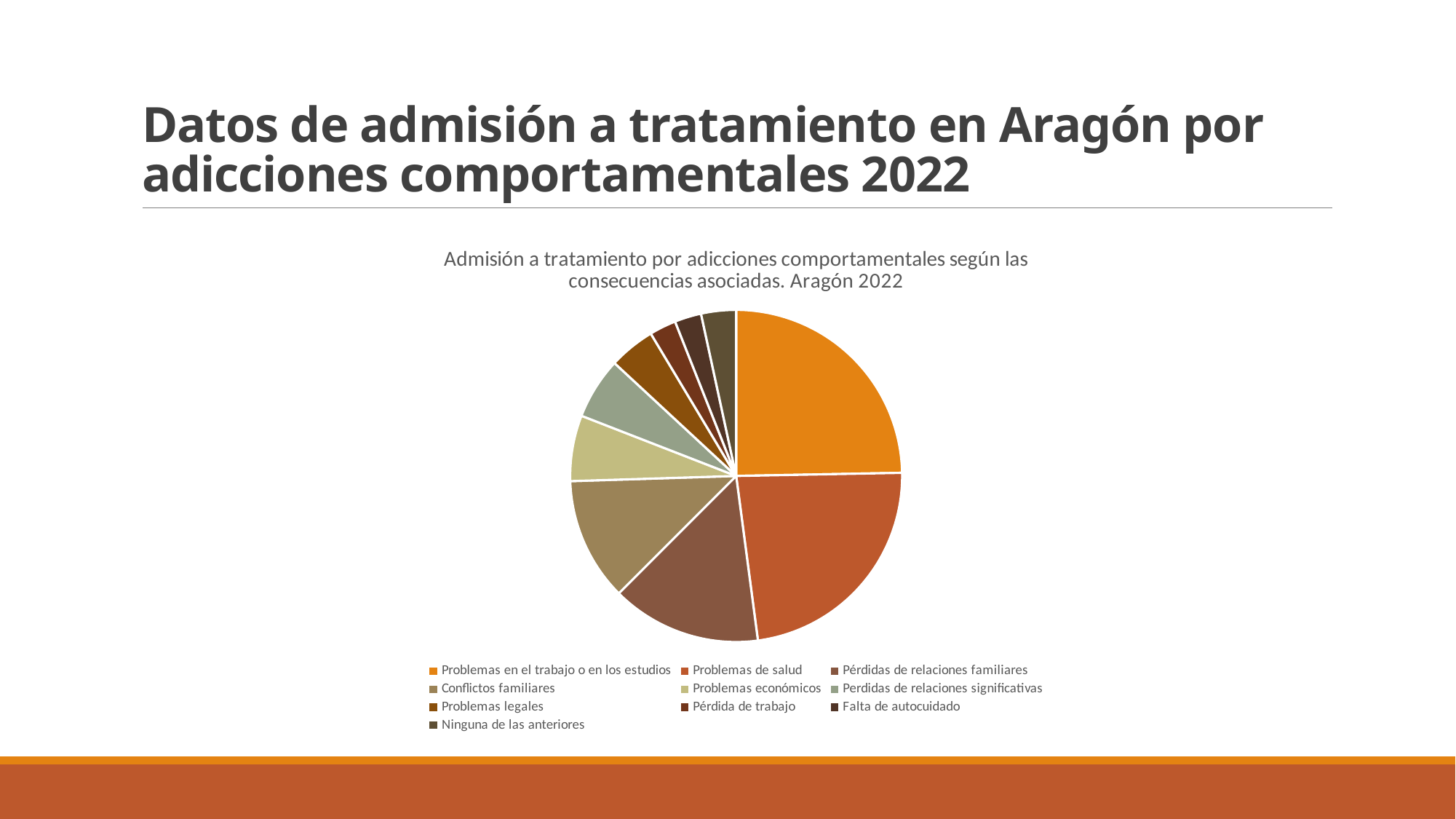
What kind of chart is shown on the slide? Pie chart Which slice is larger: "Conflictos familiares" or "Problemas legales"? Conflictos familiares What is the title of the chart? Admisión a tratamiento por adicciones comportamentales según las consecuencias asociadas. Aragón 2022 Which slice is larger: "Pérdidas de relaciones familiares" or "Perdidas de relaciones significativas"? Pérdidas de relaciones familiares Which slice is larger: "Problemas de salud" or "Conflictos familiares"? Problemas de salud What colour is the slice for "Problemas en el trabajo o en los estudios"? Orange Which legend entry is listed last in the chart's legend? Ninguna de las anteriores How many categories (slices) does the pie chart have? 10